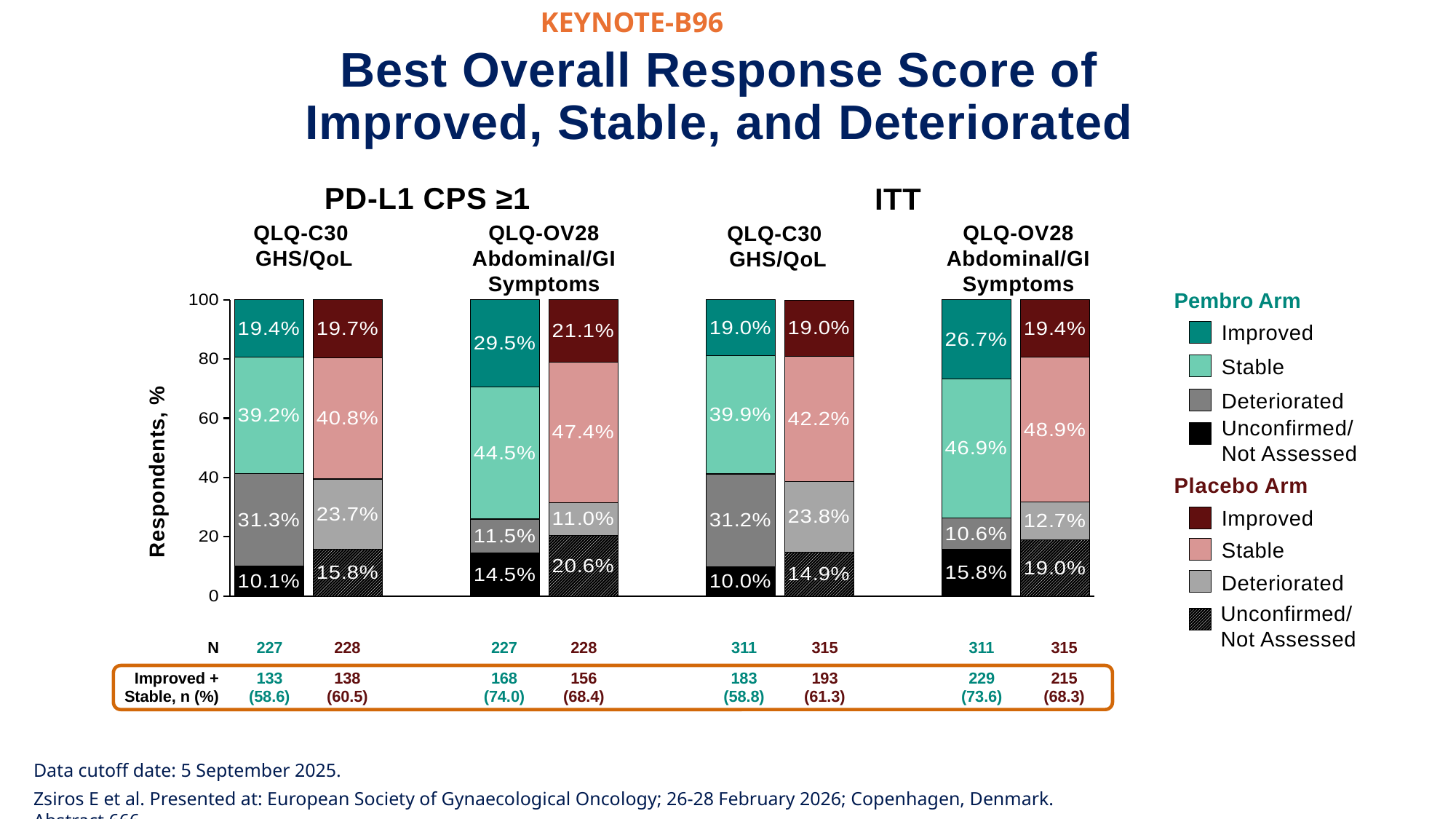
How many stacked bars are plotted in the chart? 8 What is the label of the y-axis? Respondents, % What percentage of Placebo arm respondents were Unconfirmed/Not Assessed on the QLQ-OV28 Abdominal/GI Symptoms scale in the PD-L1 CPS ≥1 population? 20.6% Across all bars, which bar has the highest Improved percentage? Pembro Arm, QLQ-OV28 Abdominal/GI Symptoms, PD-L1 CPS ≥1 (29.5%) What is the difference in the Improved percentage between the Pembro and Placebo arms on the QLQ-OV28 Abdominal/GI Symptoms scale in the ITT population? 7.3 percentage points What percentage of Pembro arm respondents were Deteriorated on the QLQ-C30 GHS/QoL scale in the PD-L1 CPS ≥1 population? 31.3% What is the Improved + Stable n (%) for the Pembro arm on the QLQ-OV28 Abdominal/GI Symptoms scale in the PD-L1 CPS ≥1 population? 168 (74.0) On the QLQ-C30 GHS/QoL scale in the ITT population, which arm has the larger Deteriorated percentage, Pembro or Placebo? Pembro What percentage of respondents in the Placebo arm were Stable on the QLQ-C30 GHS/QoL scale in the ITT population? 42.2% What type of chart is shown on the slide? Stacked bar chart How many entries does the legend list in total? 8 What percentage of respondents in the Pembro arm had an Improved best overall response on the QLQ-OV28 Abdominal/GI Symptoms scale in the PD-L1 CPS ≥1 population? 29.5%